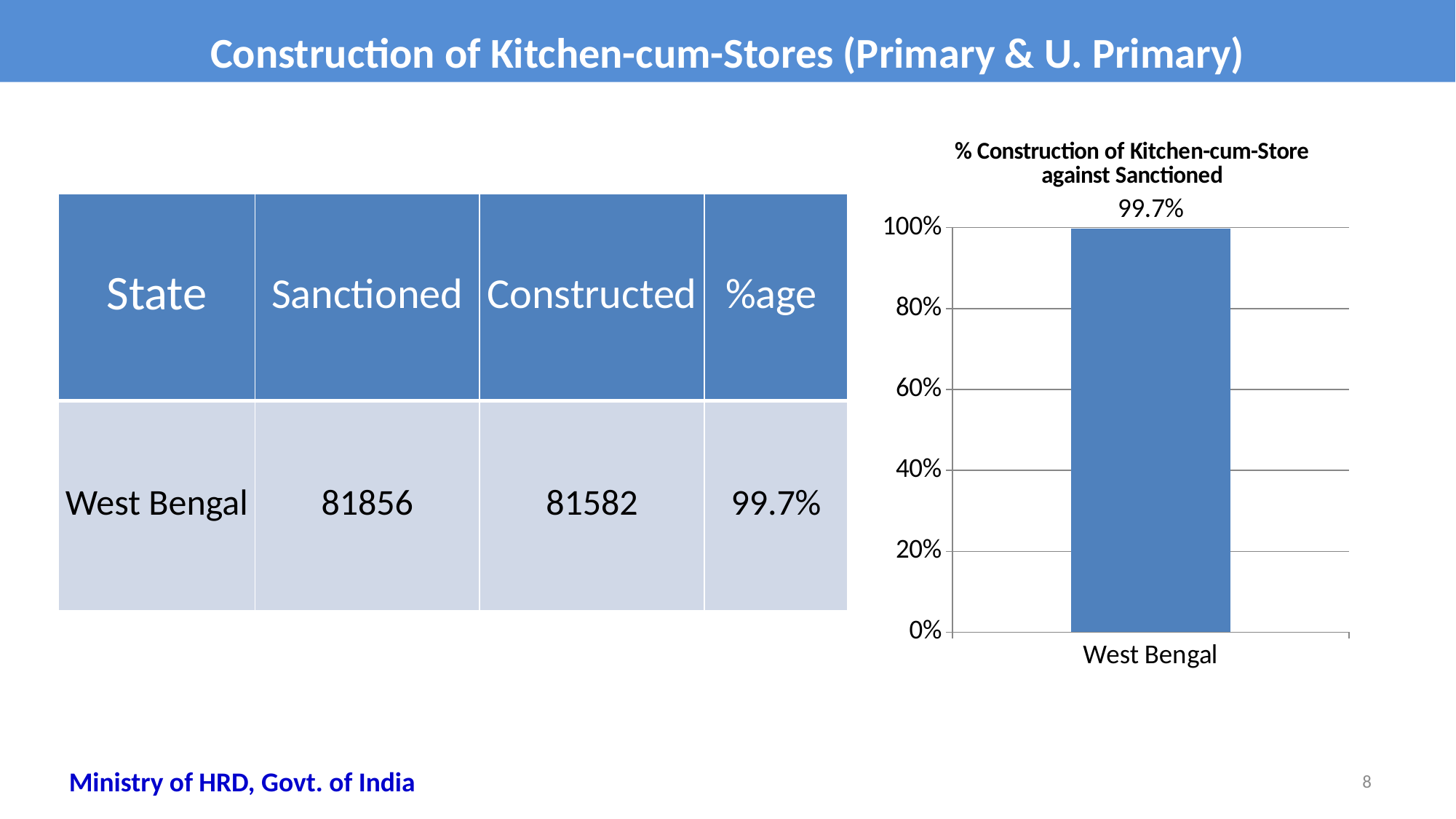
Is the value for West Bengal greater or less than 80%? greater What kind of chart is shown on the slide? bar chart What is the highest value shown on the y axis of the chart? 100% What is the value shown for West Bengal in the chart? 99.7% Which state is shown on the x axis of the chart? West Bengal Is the value for West Bengal greater or less than 100%? less What is the title of the chart? % Construction of Kitchen-cum-Store against Sanctioned How many categories are plotted in the chart? 1